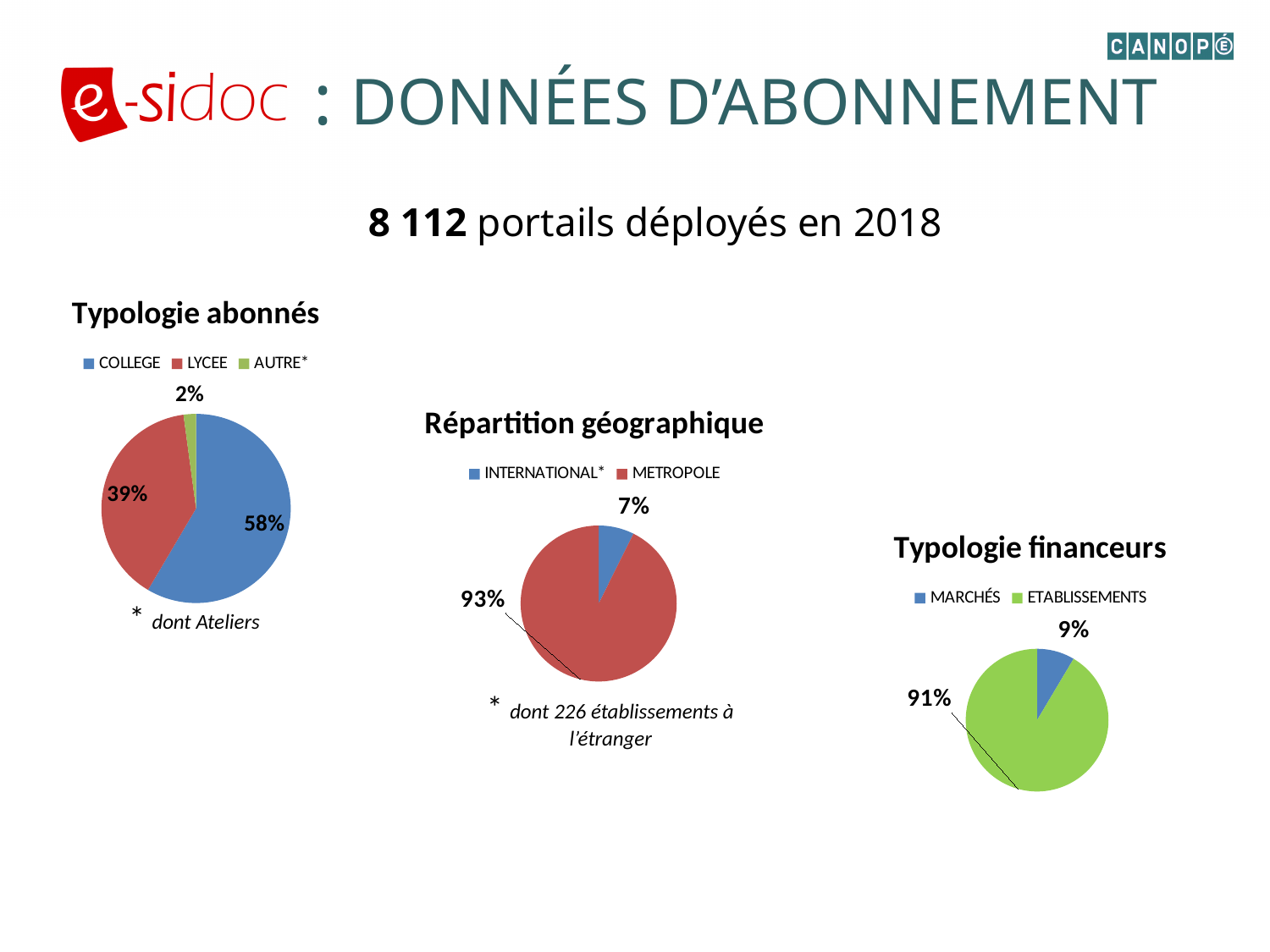
In the 'Répartition géographique' chart, which category is larger, INTERNATIONAL* or METROPOLE? METROPOLE In the 'Répartition géographique' chart, what share is METROPOLE? 93% In the 'Typologie abonnés' chart, how many categories does the legend list? 3 In the 'Typologie abonnés' chart, what share is COLLEGE? 58% In the 'Typologie financeurs' chart, what share is MARCHÉS? 9% In the 'Typologie abonnés' chart, what share is LYCEE? 39% What type of chart is the 'Typologie financeurs' chart? Pie chart How many pie charts are shown on the slide? 3 In the 'Typologie abonnés' chart, which category has the smallest share? AUTRE* In the 'Typologie abonnés' chart, what is the difference between the COLLEGE and LYCEE shares? 19% In the 'Typologie financeurs' chart, what share is ETABLISSEMENTS? 91% In the 'Répartition géographique' chart, what share is INTERNATIONAL*? 7%